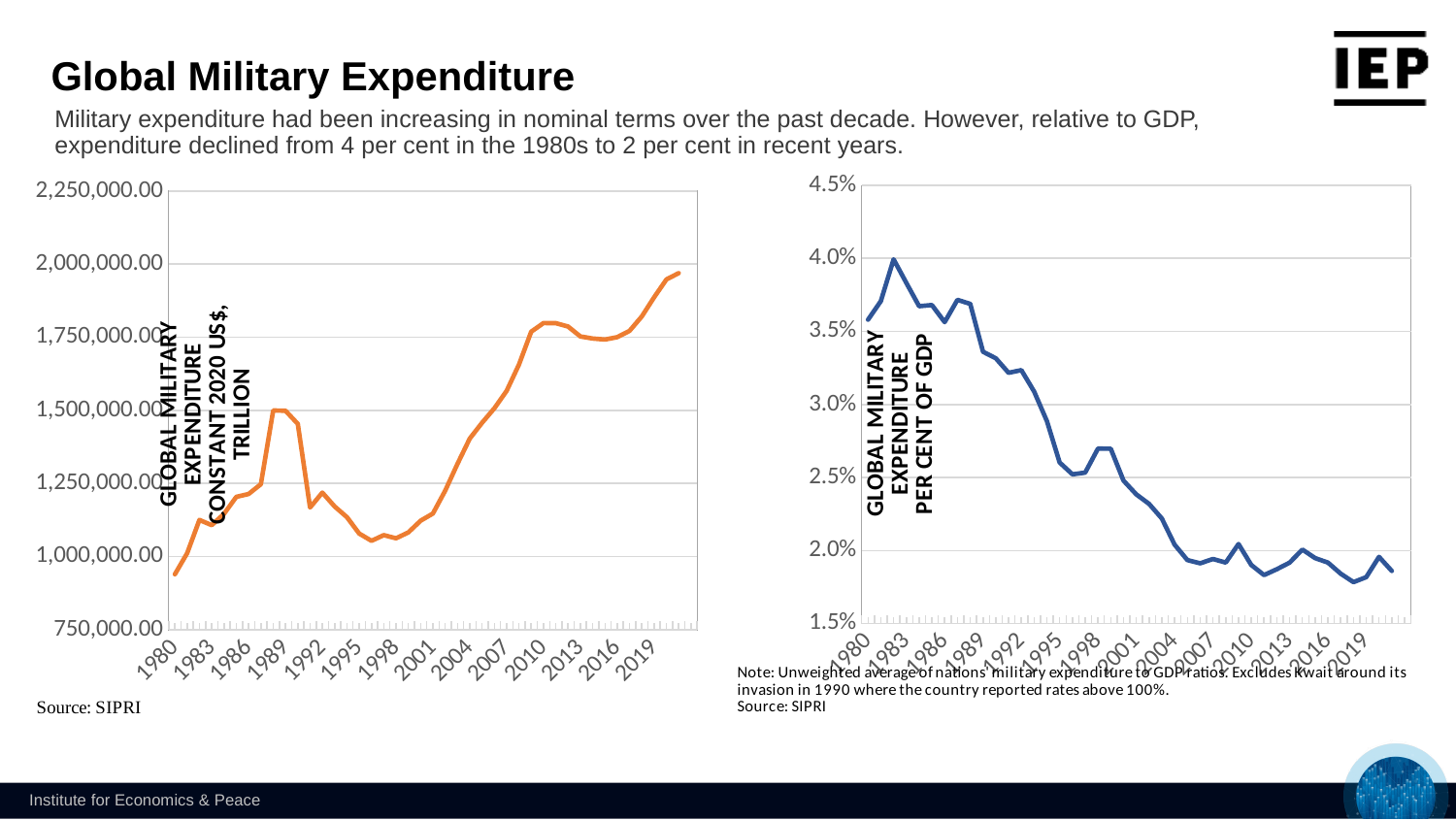
In the left chart (global military expenditure, constant 2020 US$), is the value for 1980 greater or less than 1,000,000.00? less In the right chart (military expenditure per cent of GDP), is the value for 2019 greater or less than 2.0%? less In the right chart (military expenditure per cent of GDP), do values generally rise or fall from 1980 to 2019? fall In the left chart (global military expenditure, constant 2020 US$), is the value for 2019 greater or less than 1,750,000.00? greater What kind of chart is the left chart on the slide? line chart In the left chart (global military expenditure, constant 2020 US$), do values rise or fall between 2001 and 2010? rise What is the vertical axis title of the left chart? GLOBAL MILITARY EXPENDITURE CONSTANT 2020 US$, TRILLION What kind of chart is the right chart (military expenditure per cent of GDP)? line chart